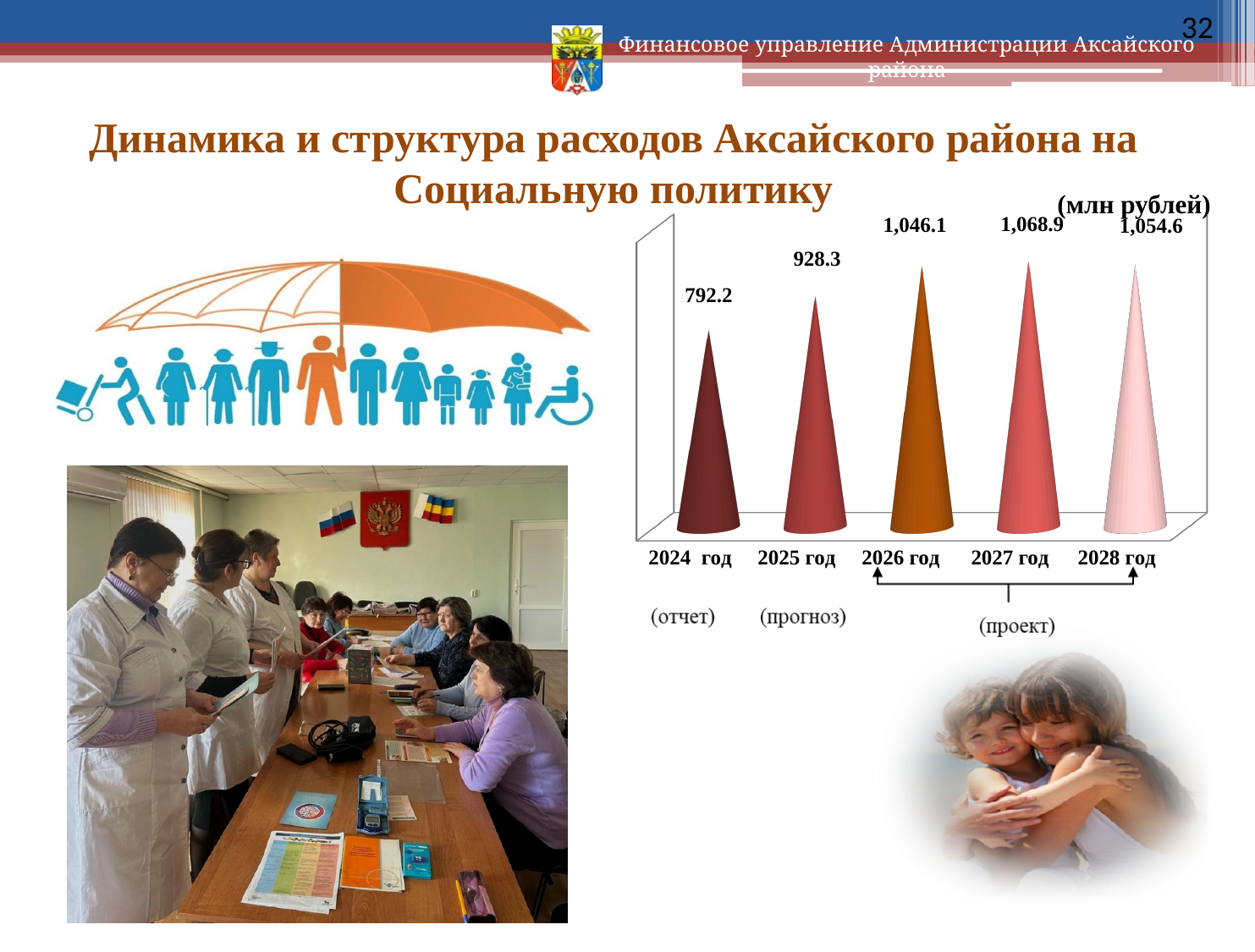
Which is larger, the value for 2025 год or the value for 2026 год? 2026 год What is the difference between the values for 2025 год and 2024 год? 136.1 What kind of chart is this? bar chart How many years are shown on the chart? 5 What is the difference between the values for 2027 год and 2028 год? 14.3 Which year has the highest value? 2027 год Do the values rise or fall from 2024 год to 2027 год? rise In what units are the chart values given? млн рублей What is the value for 2024 год? 792.2 What is the value for 2026 год? 1,046.1 What is the value for 2028 год? 1,054.6 Which year has the lowest value? 2024 год